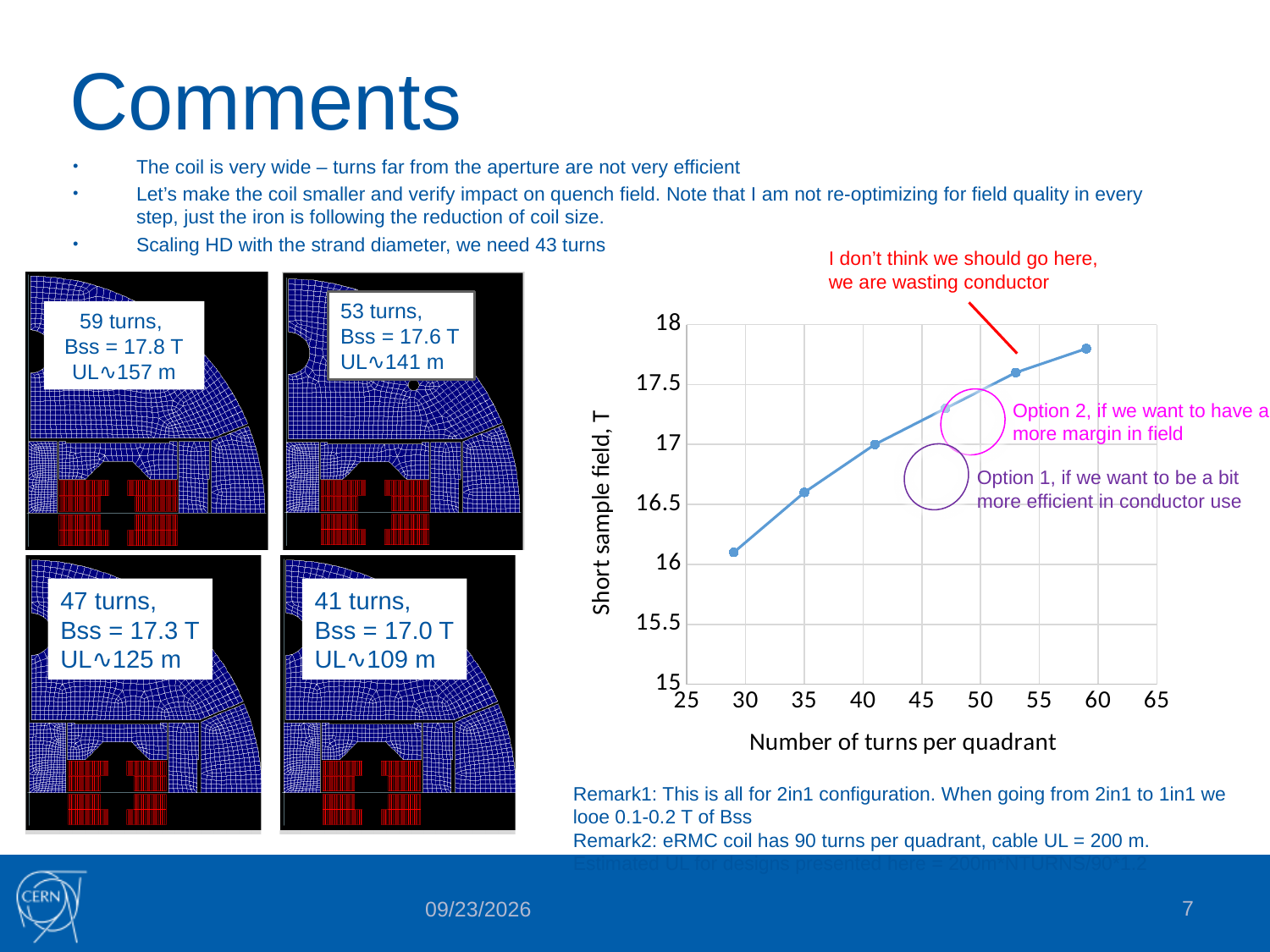
What kind of chart is shown on the slide? line chart At which number of turns per quadrant is the short sample field highest? 59 Which has the higher short sample field: 59 turns per quadrant or 41 turns per quadrant? 59 turns per quadrant Is the short sample field at 35 turns per quadrant greater or less than 17? less Does the short sample field rise or fall as the number of turns per quadrant increases? rises Is the short sample field at 59 turns per quadrant greater or less than 17.5? greater What is the title of the y axis of the chart? Short sample field, T What is the title of the x axis of the chart? Number of turns per quadrant Is the short sample field of the leftmost point greater or less than 16.5? less According to the slide, what is Bss for the 47-turn design? 17.3 T How many data points are plotted on the chart? 6